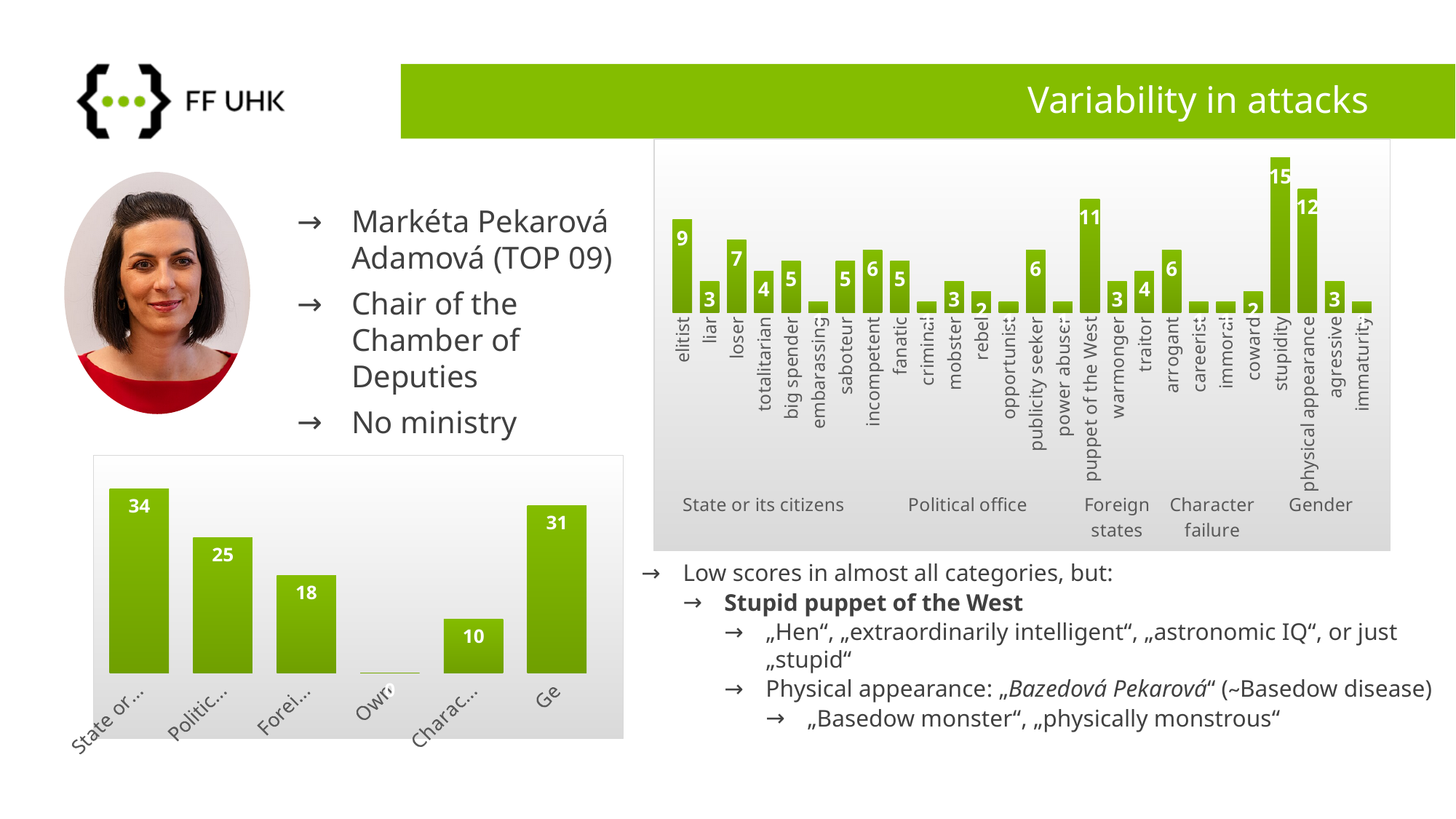
In the chart at the bottom left, what is the difference between the first bar (34) and the last bar (31)? 3 In the chart on the right, what value is shown for 'stupidity'? 15 In the chart at the bottom left, how many bars are there? 6 In the chart on the right, what is the difference between the values for 'stupidity' and 'physical appearance'? 3 In the chart on the right, what value is shown for 'arrogant'? 6 In the chart on the right, what value is shown for 'puppet of the West'? 11 In the chart at the bottom left, what is the value of the tallest bar? 34 What type of chart is shown at the bottom left of the slide? bar chart In the chart on the right, which category has the highest value? stupidity In the chart on the right, what value is shown for 'physical appearance'? 12 In the chart on the right, which has a larger value, 'elitist' or 'loser'? elitist In the chart on the right, how many group labels are shown beneath the category axis? 5